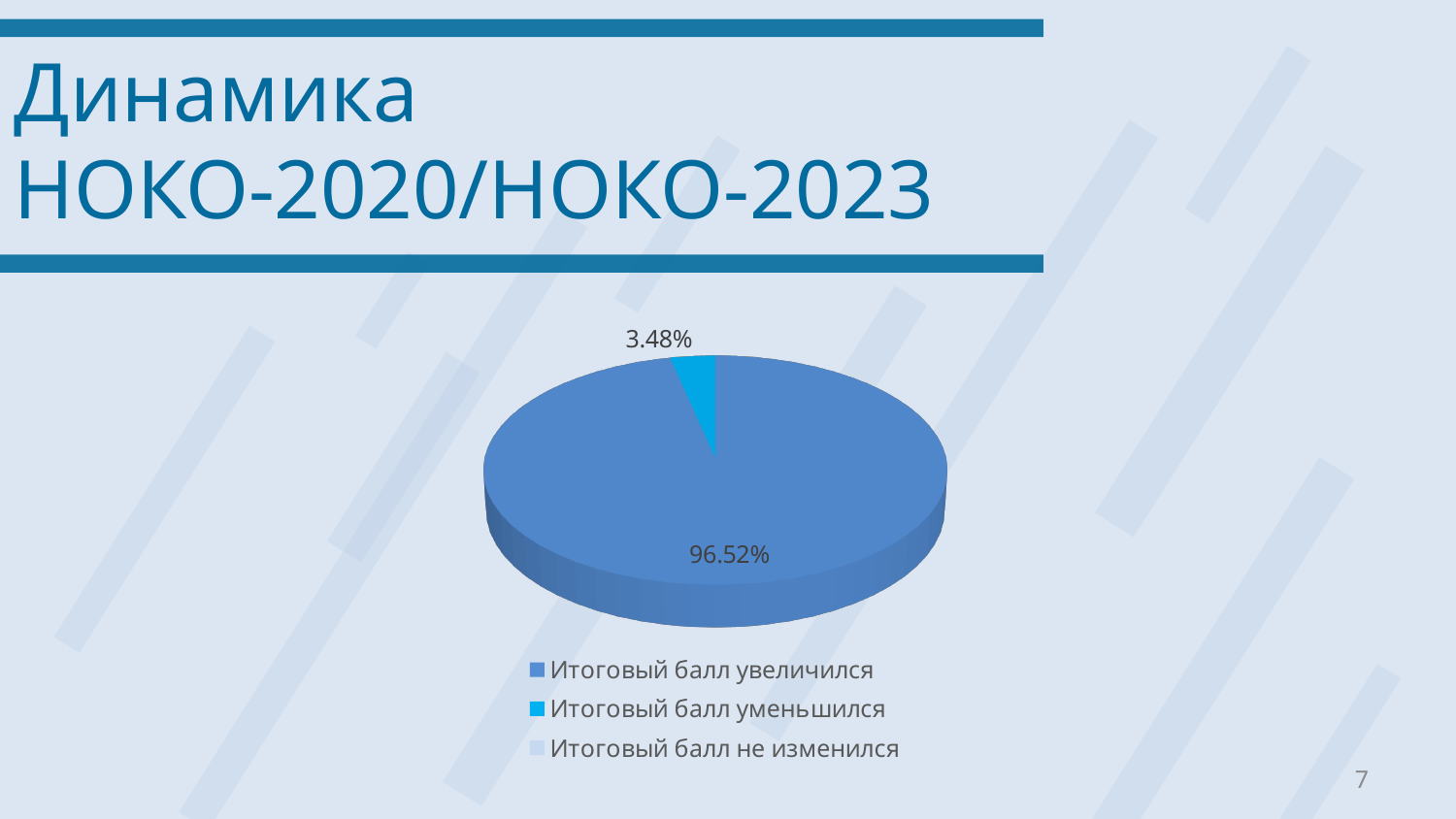
Which is larger: the slice for "Итоговый балл увеличился" or the slice for "Итоговый балл уменьшился"? Итоговый балл увеличился Is the share for "Итоговый балл увеличился" greater or less than 50%? greater Which category has the largest slice of the pie? Итоговый балл увеличился Is the share for "Итоговый балл уменьшился" greater or less than 10%? less What kind of chart is shown on the slide? Pie chart What share of the pie is labelled "Итоговый балл увеличился"? 96.52% What share of the pie is labelled "Итоговый балл уменьшился"? 3.48% What is the difference in percentage points between the "Итоговый балл увеличился" slice and the "Итоговый балл уменьшился" slice? 93.04% Which of the labelled slices is the smallest? Итоговый балл уменьшился What is the title of the slide containing the chart? Динамика НОКО-2020/НОКО-2023 Which legend entry is shown in the lightest blue colour? Итоговый балл не изменился How many entries does the chart legend list? 3